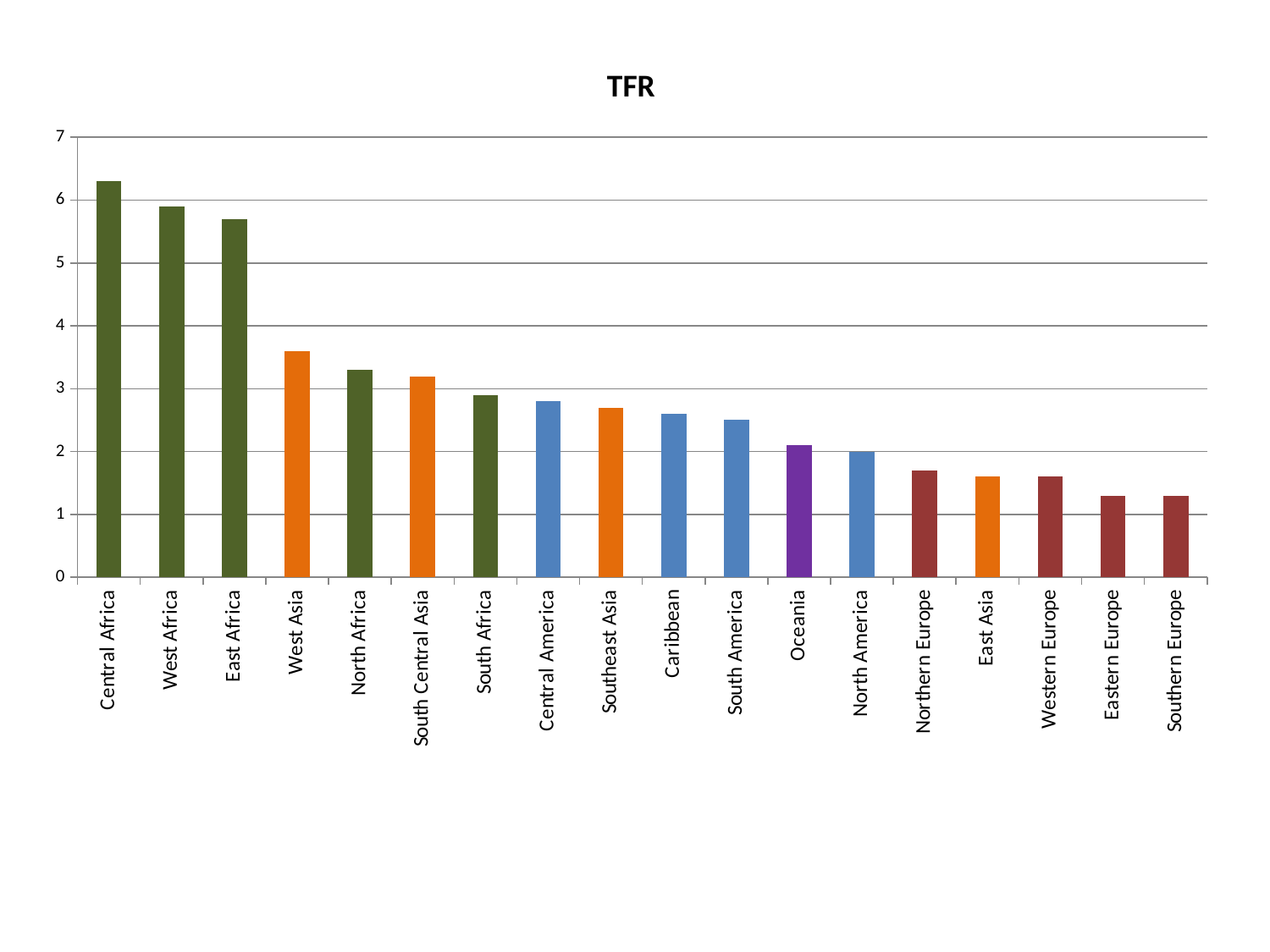
What is the title of the chart? TFR Which is larger, the value for West Africa or the value for North Africa? West Africa Which region has the highest value in the chart? Central Africa Is the value for Central Africa greater or less than 6? greater How many regions are plotted in the chart? 18 Which is larger, the value for Caribbean or the value for Eastern Europe? Caribbean Do the values generally rise or fall moving from left to right along the x axis? fall Is the value for West Asia greater or less than 4? less Is the value for Northern Europe greater or less than 2? less What kind of chart is shown on the slide? bar chart